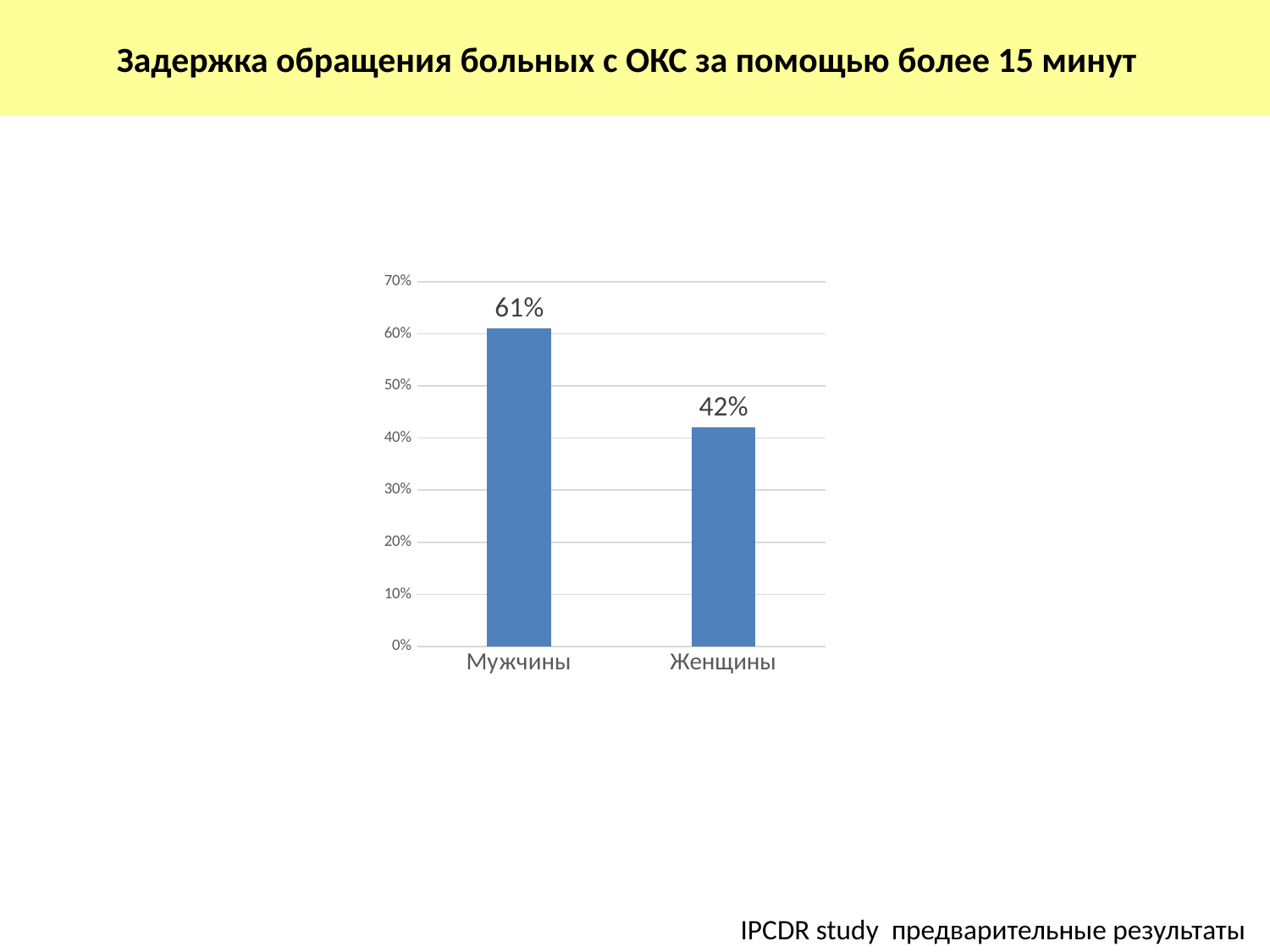
What is the maximum value shown on the y axis? 70% What is the value for Мужчины? 61% What is the value for Женщины? 42% Which category has the lowest value? Женщины Is the value for Мужчины greater or less than 60%? greater Which category has the highest value? Мужчины Is the value for Женщины greater or less than 50%? less How many categories are shown on the x axis? 2 What kind of chart is shown on the slide? bar chart What is the difference between the values for Мужчины and Женщины? 19% Which is larger, the value for Мужчины or the value for Женщины? Мужчины What is the title of the slide? Задержка обращения больных с ОКС за помощью более 15 минут